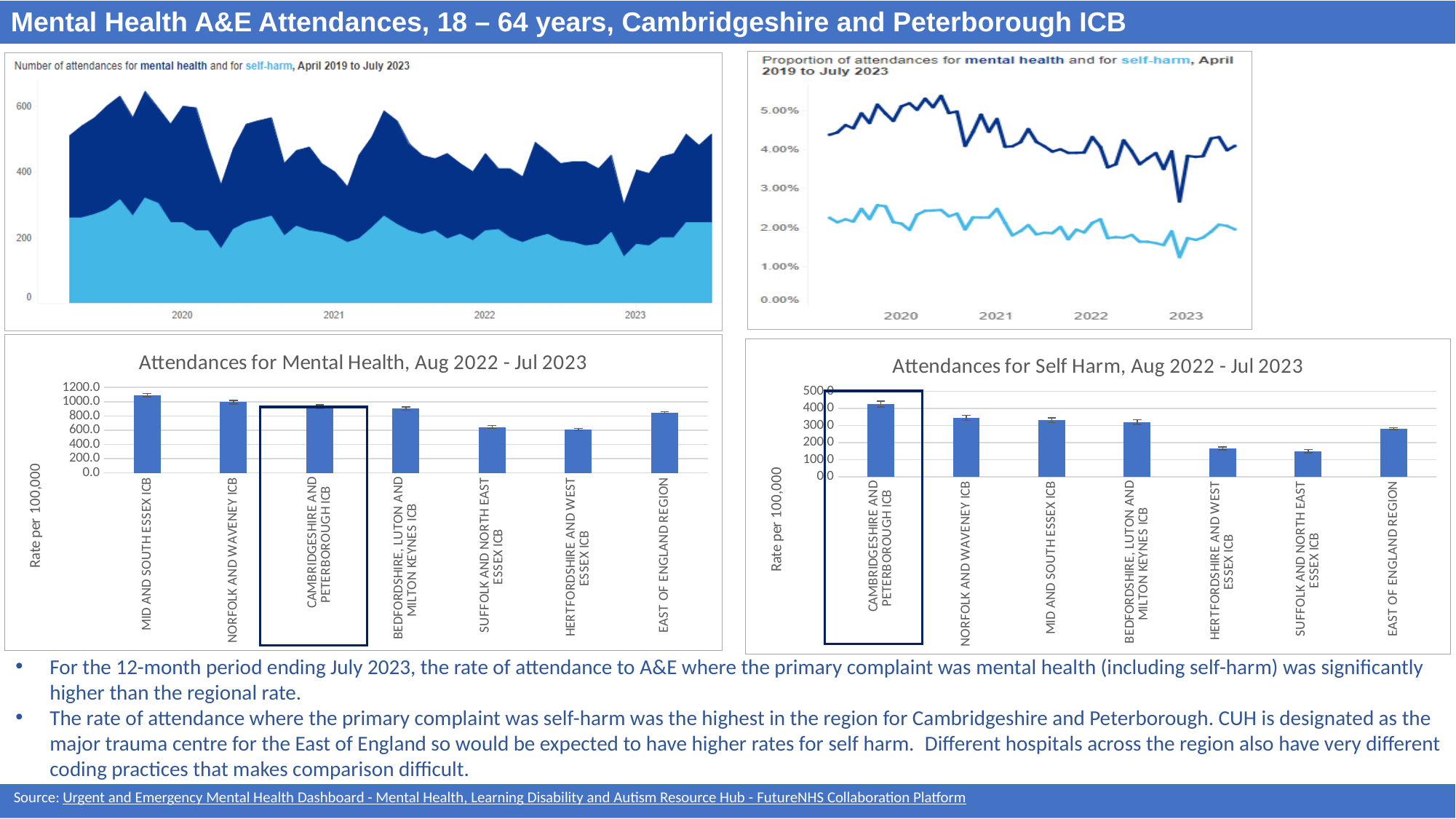
In the 'Attendances for Self Harm, Aug 2022 - Jul 2023' chart, which is larger: the value for CAMBRIDGESHIRE AND PETERBOROUGH ICB or the value for EAST OF ENGLAND REGION? CAMBRIDGESHIRE AND PETERBOROUGH ICB What is the y-axis label of the 'Attendances for Mental Health, Aug 2022 - Jul 2023' chart? Rate per 100,000 In the 'Attendances for Mental Health, Aug 2022 - Jul 2023' chart, which is larger: the value for NORFOLK AND WAVENEY ICB or the value for SUFFOLK AND NORTH EAST ESSEX ICB? NORFOLK AND WAVENEY ICB In the 'Attendances for Mental Health, Aug 2022 - Jul 2023' chart, is the value for MID AND SOUTH ESSEX ICB greater or less than 1000.0? greater In the 'Attendances for Self Harm, Aug 2022 - Jul 2023' chart, is the value for HERTFORDSHIRE AND WEST ESSEX ICB greater or less than 200? less How many categories are shown in the 'Attendances for Mental Health, Aug 2022 - Jul 2023' chart? 7 In the 'Attendances for Mental Health, Aug 2022 - Jul 2023' chart, is the value for HERTFORDSHIRE AND WEST ESSEX ICB greater or less than 800.0? less What kind of chart is 'Attendances for Self Harm, Aug 2022 - Jul 2023'? bar chart In the 'Attendances for Self Harm, Aug 2022 - Jul 2023' chart, which category has the highest rate? CAMBRIDGESHIRE AND PETERBOROUGH ICB What kind of chart is the top-right chart, 'Proportion of attendances for mental health and for self-harm, April 2019 to July 2023'? line chart In the 'Attendances for Mental Health, Aug 2022 - Jul 2023' chart, which category has the highest rate? MID AND SOUTH ESSEX ICB